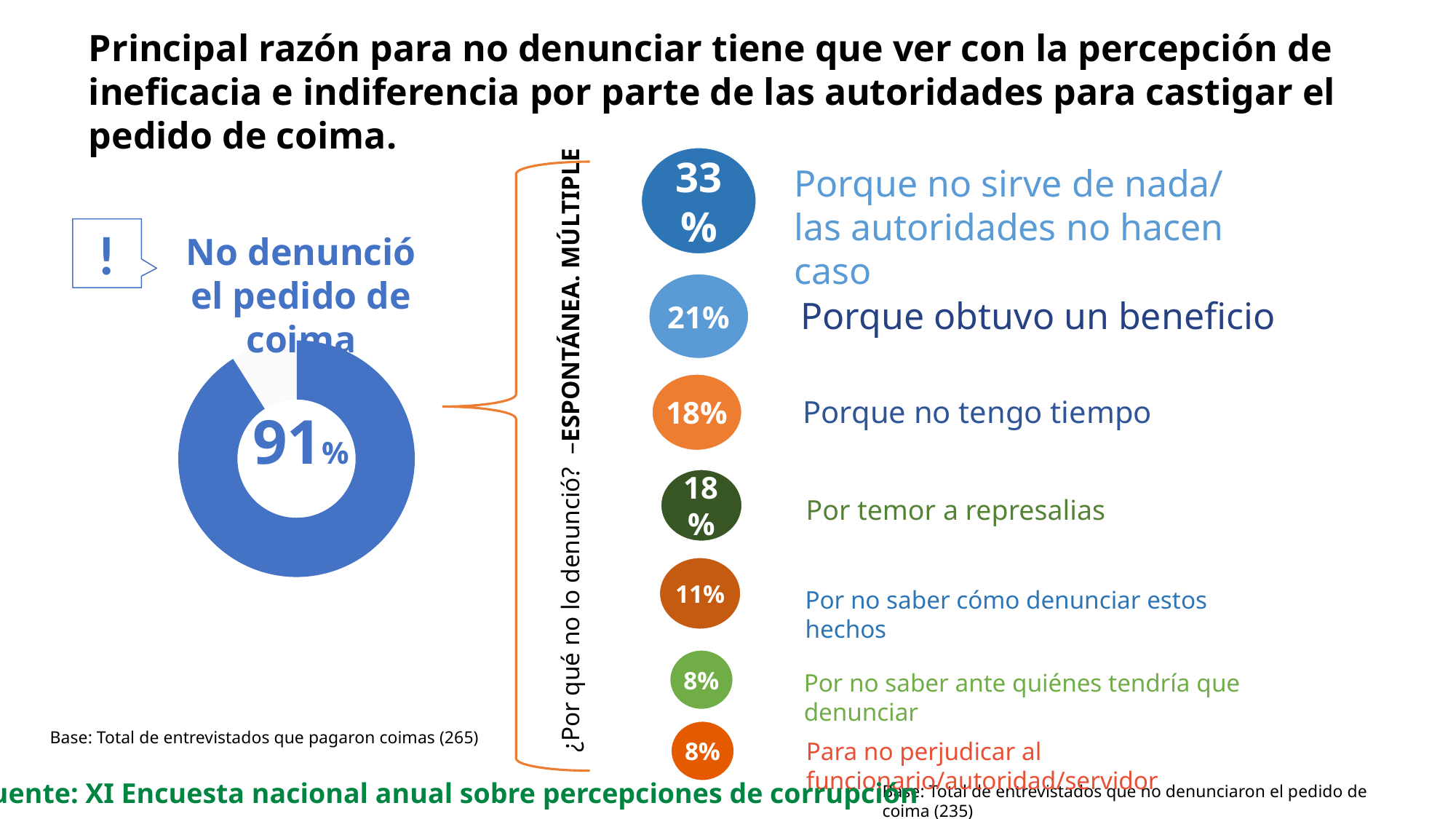
How many slices does the donut chart on the left have? 2 How many reasons for not reporting are listed on the right side of the slide? 7 Which reason for not reporting has the highest percentage on the right side of the slide? Porque no sirve de nada/las autoridades no hacen caso In the donut chart, is the value for 'No denunció el pedido de coima' greater or less than 50%? greater In the list of reasons on the right, what percentage corresponds to 'Por temor a represalias'? 18% Which has a higher percentage: 'Porque obtuvo un beneficio' or 'Porque no tengo tiempo'? Porque obtuvo un beneficio What kind of chart is shown on the left of the slide? Donut (pie) chart In the list of reasons on the right, what percentage corresponds to 'Por no saber cómo denunciar estos hechos'? 11% In the list of reasons on the right, what percentage corresponds to 'Porque no sirve de nada/las autoridades no hacen caso'? 33% In the list of reasons on the right, what percentage corresponds to 'Porque obtuvo un beneficio'? 21% In the donut chart on the left, what percentage did not report the bribe request (No denunció el pedido de coima)? 91% What is the difference in percentage points between 'Porque no sirve de nada/las autoridades no hacen caso' and 'Porque obtuvo un beneficio'? 12 percentage points